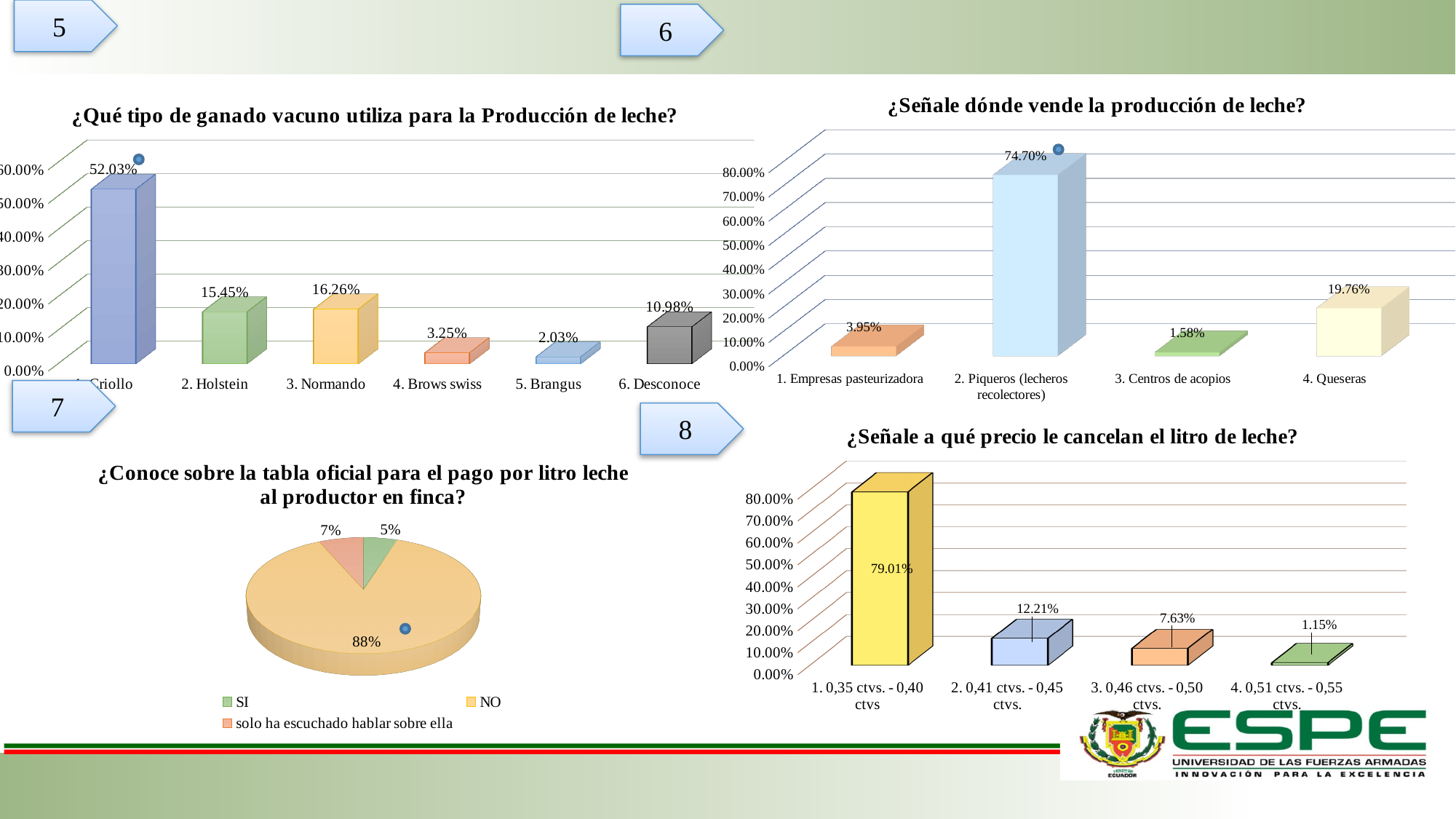
In the chart '¿Señale dónde vende la producción de leche?', what is the value for 2. Piqueros (lecheros recolectores)? 74.70% In the chart '¿Señale a qué precio le cancelan el litro de leche?', do the values rise or fall from left to right along the x axis? fall In the chart '¿Señale dónde vende la producción de leche?', what is the value for 4. Queseras? 19.76% In the chart '¿Señale a qué precio le cancelan el litro de leche?', what is the value for 2. 0,41 ctvs. - 0,45 ctvs.? 12.21% In the chart '¿Qué tipo de ganado vacuno utiliza para la Producción de leche?', what is the value for 1. Criollo? 52.03% In the chart '¿Qué tipo de ganado vacuno utiliza para la Producción de leche?', how many categories are shown? 6 In the chart '¿Señale dónde vende la producción de leche?', which is larger: 1. Empresas pasteurizadora or 3. Centros de acopios? 1. Empresas pasteurizadora In the chart '¿Qué tipo de ganado vacuno utiliza para la Producción de leche?', which category has the lowest value? 5. Brangus In the chart '¿Señale dónde vende la producción de leche?', which category has the highest value? 2. Piqueros (lecheros recolectores) In the chart '¿Qué tipo de ganado vacuno utiliza para la Producción de leche?', what is the difference between 3. Normando and 2. Holstein? 0.81% What kind of chart is '¿Conoce sobre la tabla oficial para el pago por litro leche al productor en finca?'? pie chart In the pie chart '¿Conoce sobre la tabla oficial para el pago por litro leche al productor en finca?', what share does NO have? 88%